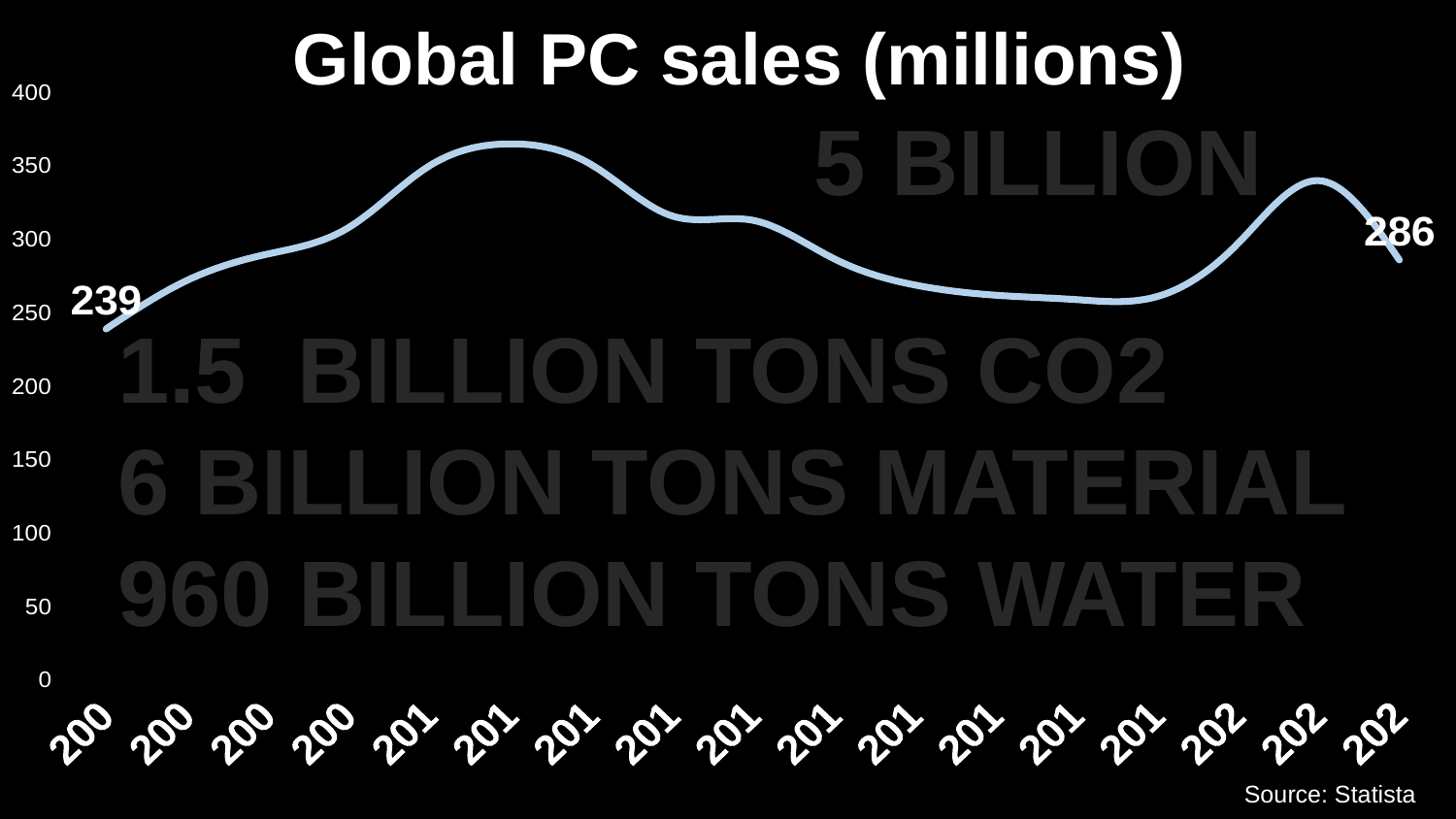
What is the value of the last data point on the line? 286 Is the highest point of the line greater or less than 350? greater Is the first data point greater or less than 250? less Is the last data point greater or less than 300? less Which is larger, the first data point or the last data point on the line? the last data point (286) What source is cited for the chart data? Statista What kind of chart is shown on the slide? line chart How many data points are plotted on the line? 17 What is the difference between the last data point (286) and the first data point (239)? 47 What is the value of the first data point on the line? 239 What is the title of the chart? Global PC sales (millions) Comparing the first and last data points, does the line end higher or lower than it starts? higher